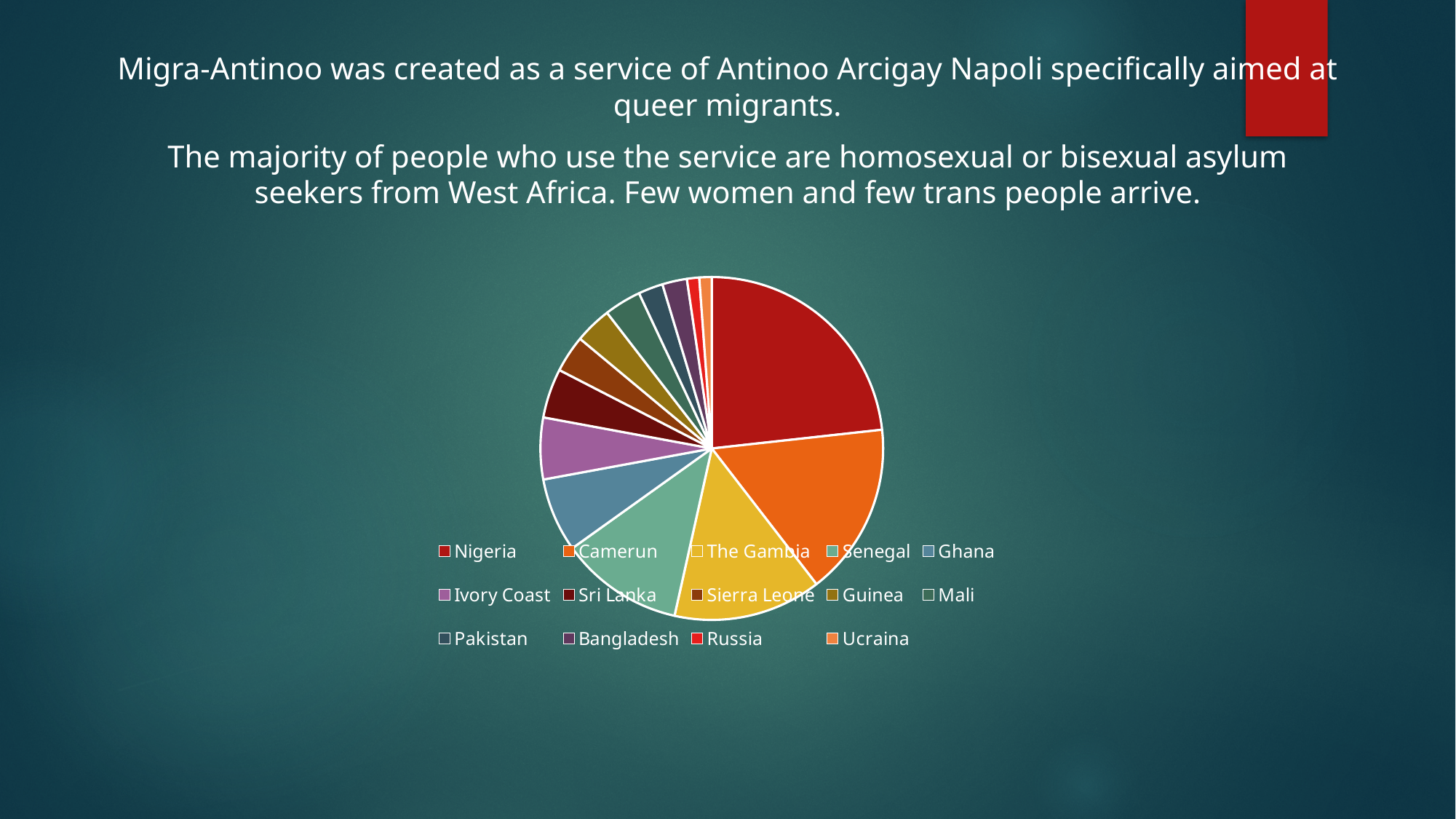
Which slice is larger, Camerun or Ghana? Camerun Which slice is larger, Nigeria or Camerun? Nigeria What kind of chart is shown on the slide? pie chart Which slice is larger, The Gambia or Mali? The Gambia Which country is listed first in the pie chart's legend? Nigeria Which country is listed last in the pie chart's legend? Ucraina Which country has the largest slice of the pie chart? Nigeria How many categories does the pie chart's legend list? 14